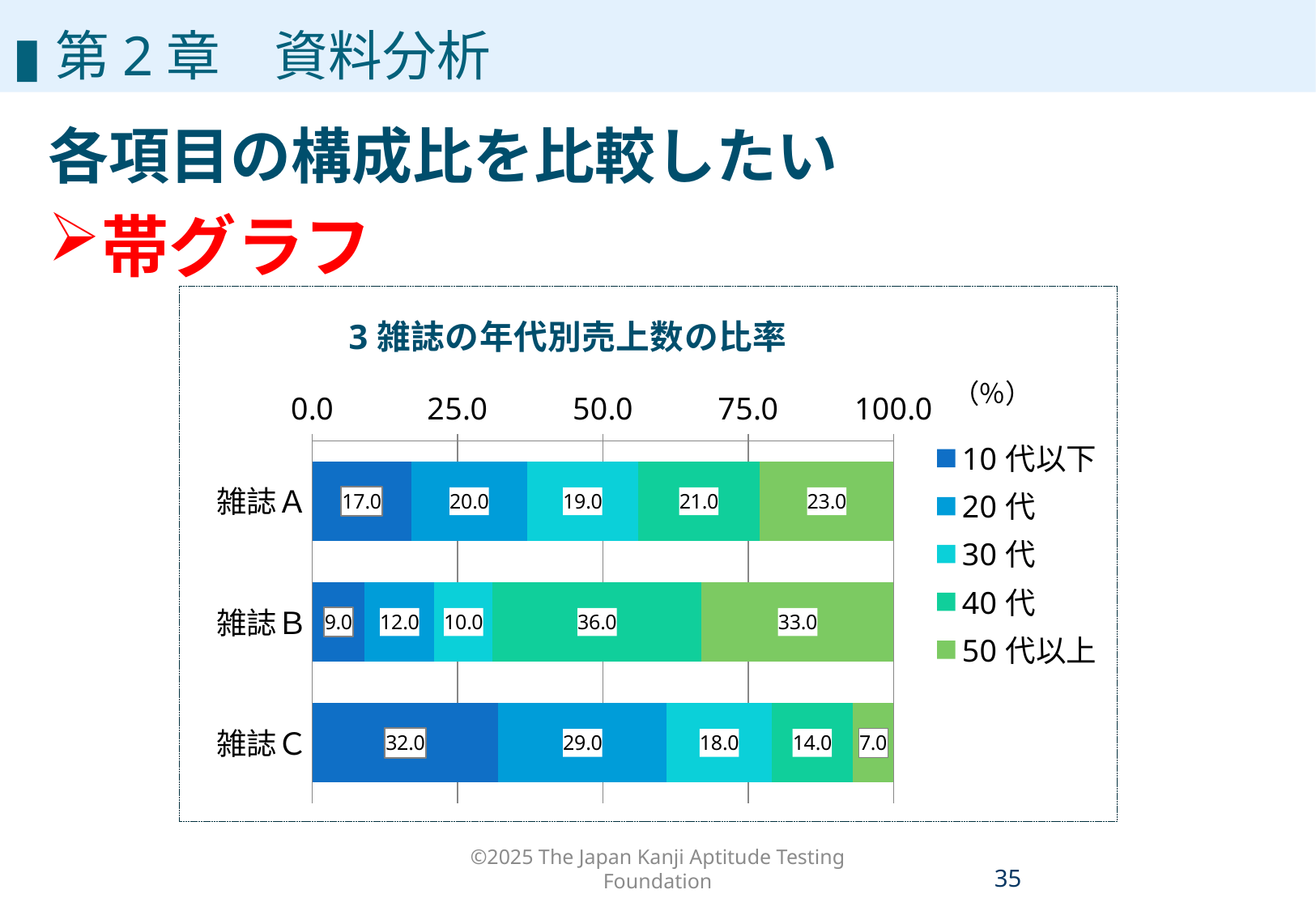
What is the value for 20代 in 雑誌A? 20.0 Which is larger: the 30代 value for 雑誌A or for 雑誌C? 雑誌A Which age group has the lowest value in 雑誌B? 10代以下 What is the total of the stacked bar for 雑誌A? 100.0 Which magazine has the highest value for 10代以下? 雑誌C What is the value for 50代以上 in 雑誌C? 7.0 How many series does the legend list? 5 What is the value for 40代 in 雑誌B? 36.0 How many magazines (categories) are shown in the chart? 3 What is the difference between the 50代以上 values for 雑誌B and 雑誌C? 26.0 What kind of chart is shown on the slide? Stacked bar chart What is the title of the chart? 3雑誌の年代別売上数の比率